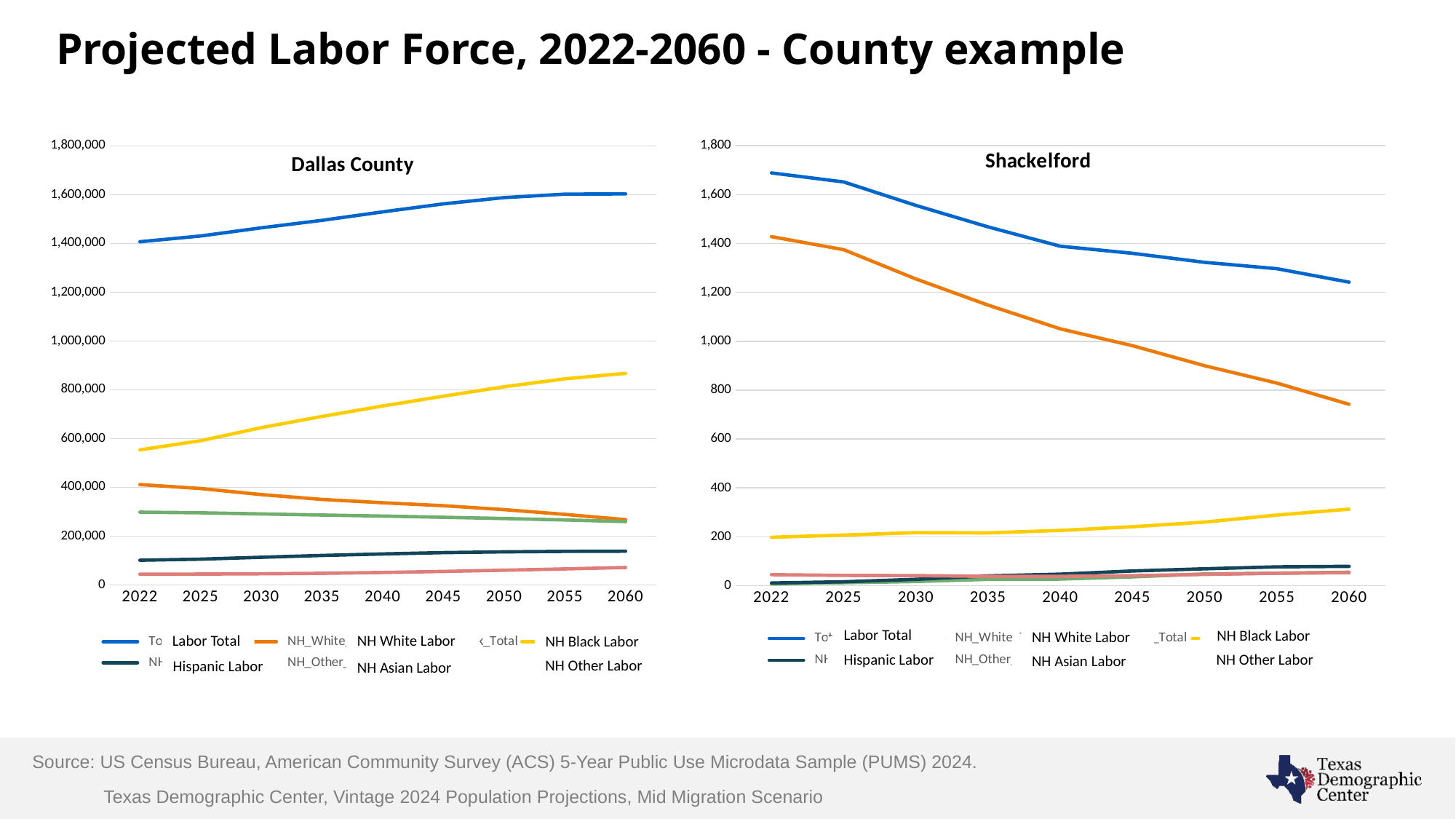
In the Dallas County chart, does the Labor Total line rise or fall from 2022 to 2060? rise What kind of chart is the Dallas County chart? line chart In the Dallas County chart, is the Labor Total value for 2022 greater or less than 1,200,000? greater In the Dallas County chart, does the NH White Labor line rise or fall over the period? fall How many series does the legend of the Shackelford chart list? 6 In the Shackelford chart, does the NH Black Labor line rise or fall over the period? rise In the Dallas County chart, which series has the lowest value in 2022? NH Other Labor In the Dallas County chart, which is larger in 2022: NH Black Labor or NH White Labor? NH Black Labor How many years are marked on the x axis of the Dallas County chart? 9 In the Shackelford chart, is the NH White Labor value for 2060 greater or less than 800? less In the Shackelford chart, which is larger in 2060: NH White Labor or NH Black Labor? NH White Labor